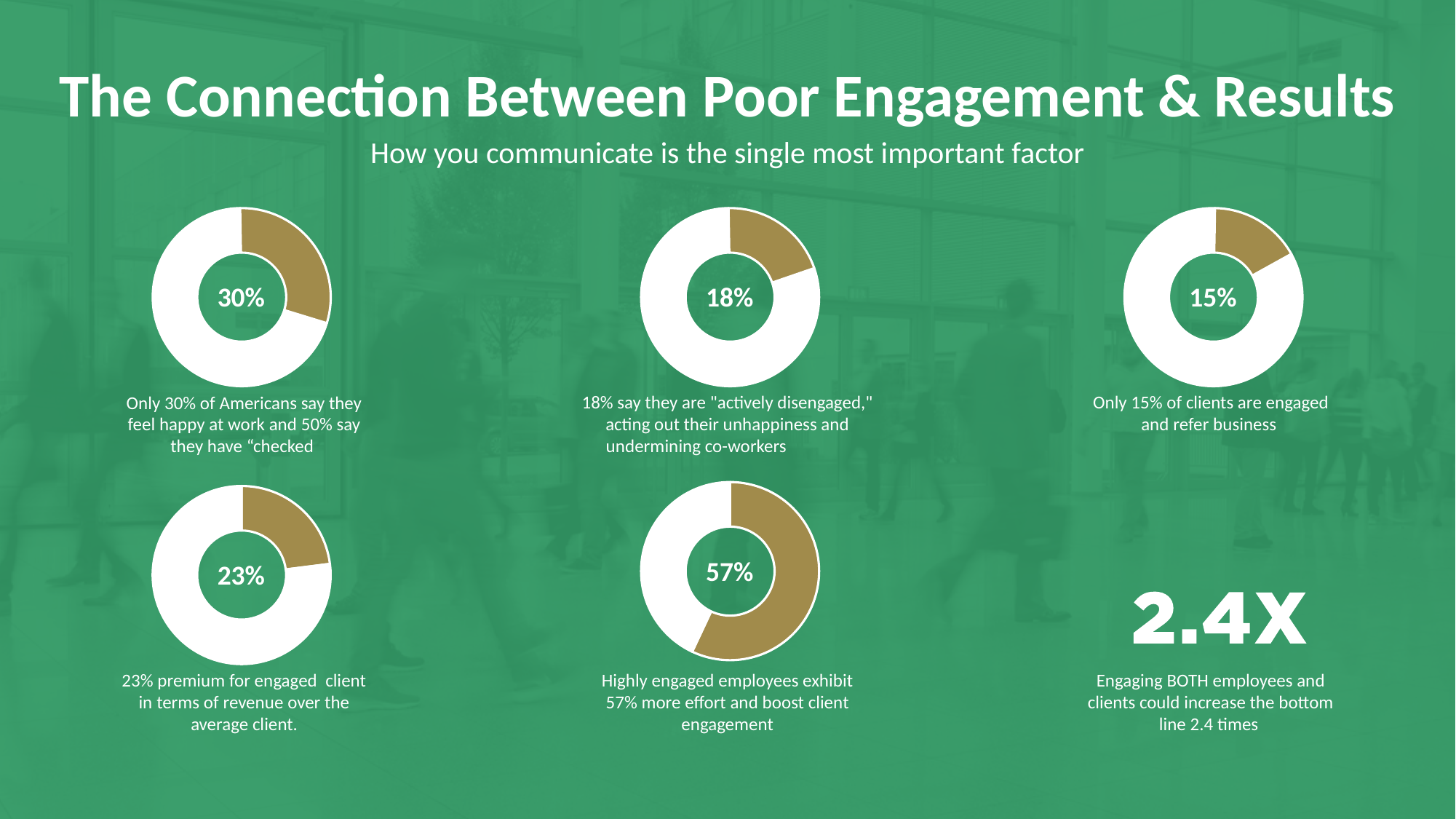
How many donut charts are shown on the slide? 5 Which donut chart on the slide shows the highest percentage? The bottom-middle chart (57%) Which is larger: the percentage in the bottom-left donut chart or the percentage in the top-middle donut chart? The bottom-left chart (23%) What colour is the highlighted slice in each donut chart on the slide? Gold What value is shown in the centre of the top-middle donut chart? 18% Which donut chart on the slide shows the lowest percentage? The top-right chart (15%) What value is shown in the centre of the bottom-middle donut chart? 57% What kind of chart is used to show the 30% figure in the top-left of the slide? Donut chart What value is shown in the centre of the top-left donut chart? 30% What value is shown in the centre of the bottom-left donut chart? 23% What value is shown in the centre of the top-right donut chart? 15% What is the difference between the percentage in the bottom-middle donut chart and the percentage in the top-left donut chart? 27%